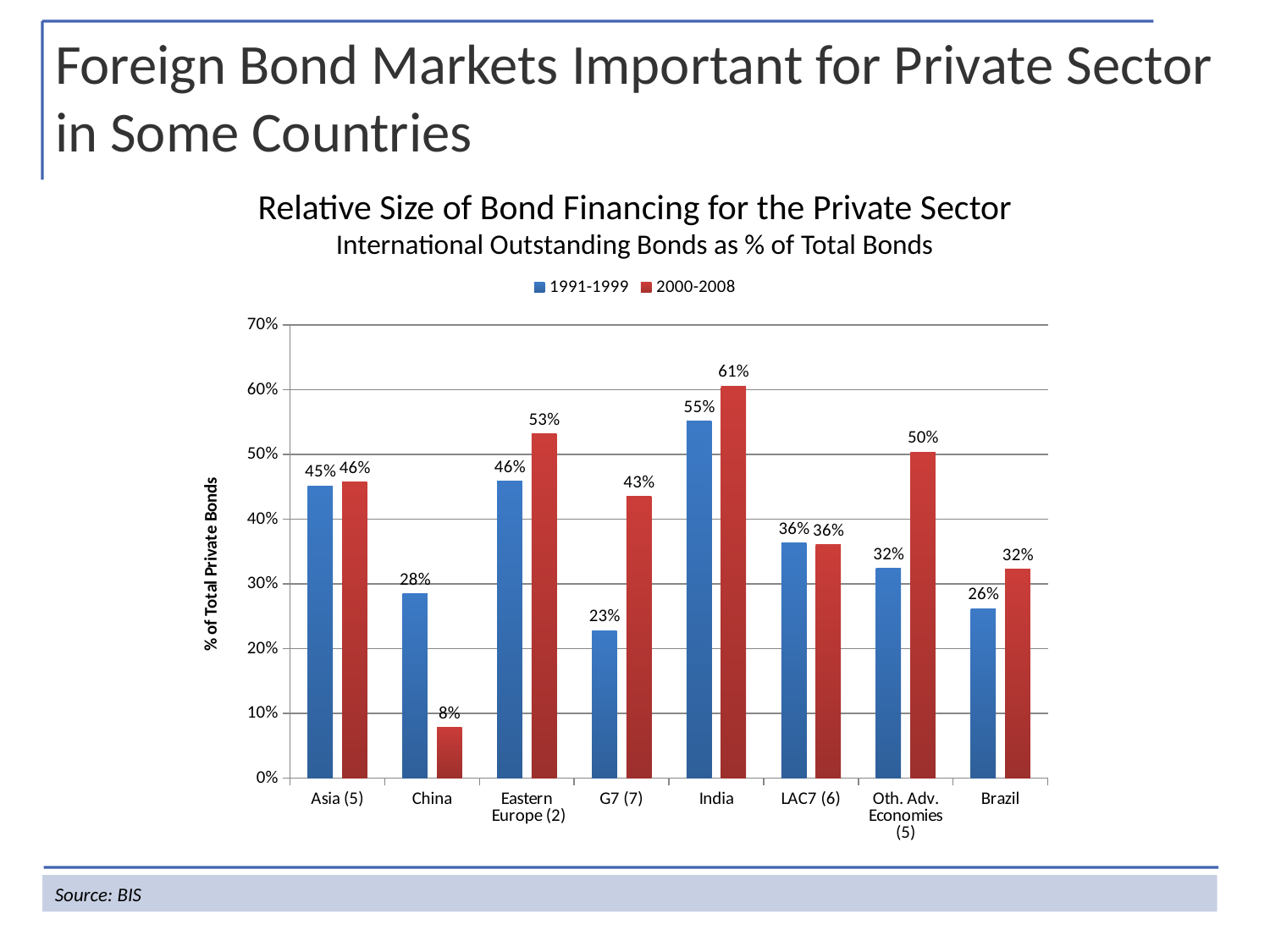
What is the difference between the 2000-2008 and 1991-1999 values for Oth. Adv. Economies (5)? 18% What is the value for India in the 2000-2008 series? 61% Which category has the highest value in the 2000-2008 series? India How many series does the legend list? 2 How many categories are shown on the x axis? 8 What is the label on the vertical axis? % of Total Private Bonds What is the difference between the 2000-2008 and 1991-1999 values for G7 (7)? 20% Which category has the lowest value in the 2000-2008 series? China What is the value for G7 (7) in the 2000-2008 series? 43% What is the value for China in the 1991-1999 series? 28% What kind of chart is shown on the slide? Bar chart Which is larger for China: the 1991-1999 value or the 2000-2008 value? 1991-1999